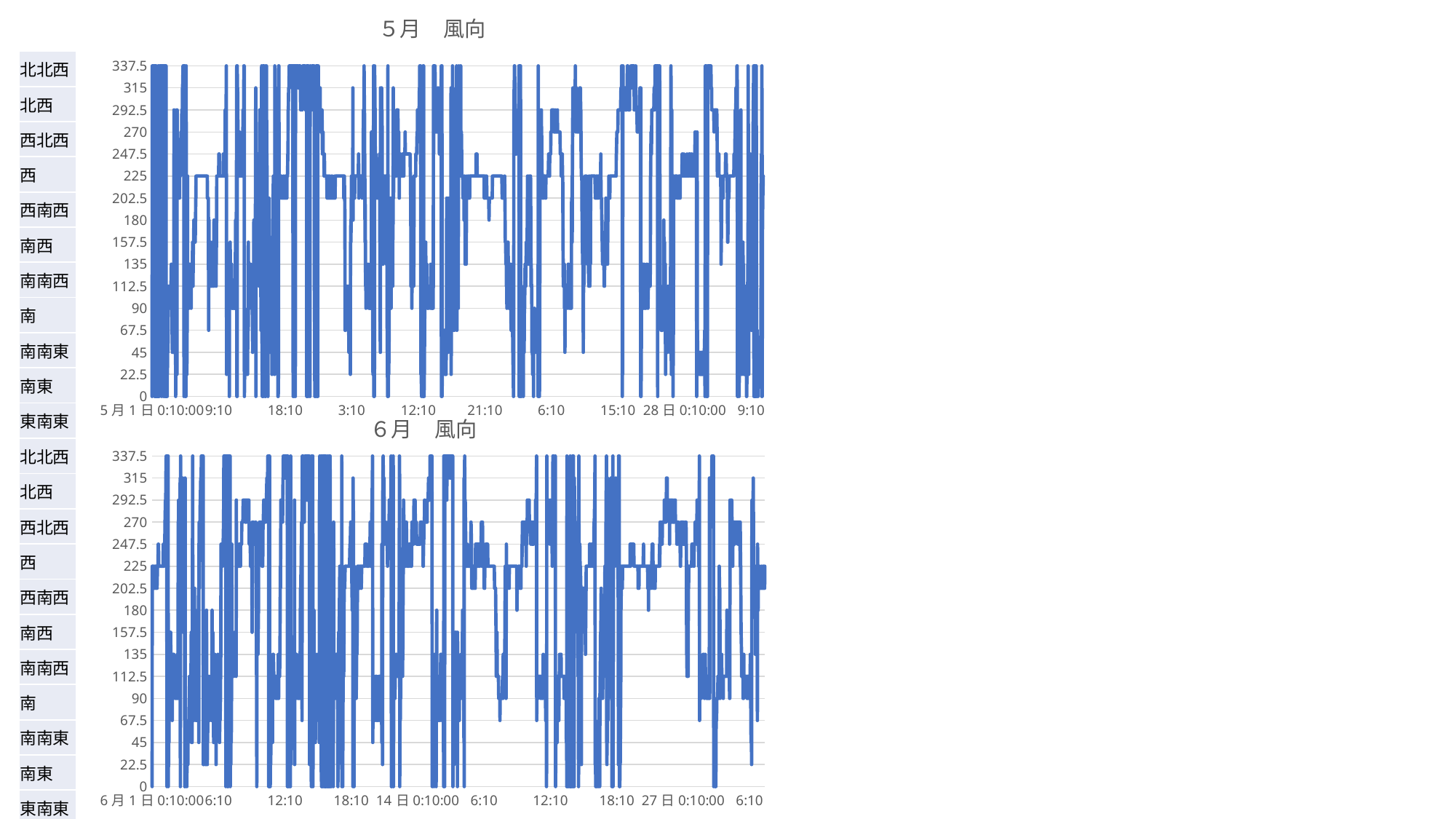
On the "６月 風向" chart, what is the interval between consecutive vertical-axis ticks? 22.5 On the "５月 風向" chart, what is the highest value shown on the vertical axis? 337.5 What is the title of the bottom chart? ６月 風向 On the "６月 風向" chart, how many tick labels are on the horizontal axis? 10 On the "６月 風向" chart, what is the lowest value shown on the vertical axis? 0 On the "６月 風向" chart, what is the first label on the horizontal axis? ６月１日 0:10:00 What kind of chart is the "６月 風向" chart? line chart How many charts are shown on the slide? 2 On the "５月 風向" chart, how many tick labels are on the vertical axis? 16 What is the title of the top chart? ５月 風向 What kind of chart is the "５月 風向" chart? line chart On the "５月 風向" chart, what is the first label on the horizontal axis? ５月１日 0:10:00